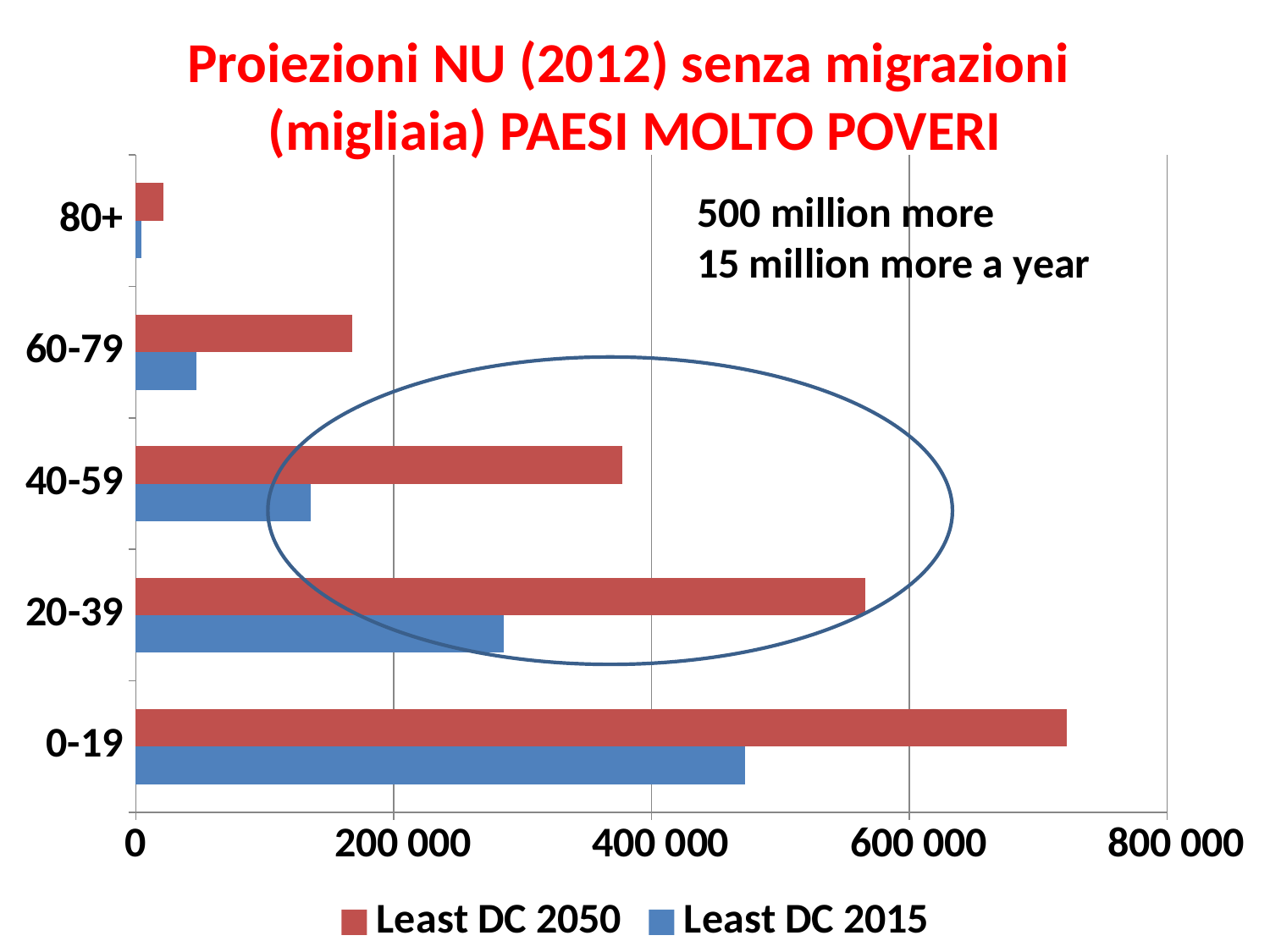
How many age groups are shown on the chart? 5 Which age group has the lowest value for Least DC 2050? 80+ Is the value for Least DC 2050 in the 0-19 age group greater or less than 600 000? greater Which age group has the lowest value for Least DC 2015? 80+ Is the value for Least DC 2015 in the 0-19 age group greater or less than 400 000? greater Which age group has the highest value for Least DC 2050? 0-19 For the 20-39 age group, which series has the larger value, Least DC 2050 or Least DC 2015? Least DC 2050 What kind of chart is shown on the slide? bar chart Which colour represents the Least DC 2015 series? blue Is the value for Least DC 2015 in the 40-59 age group greater or less than 200 000? less How many series does the legend list? 2